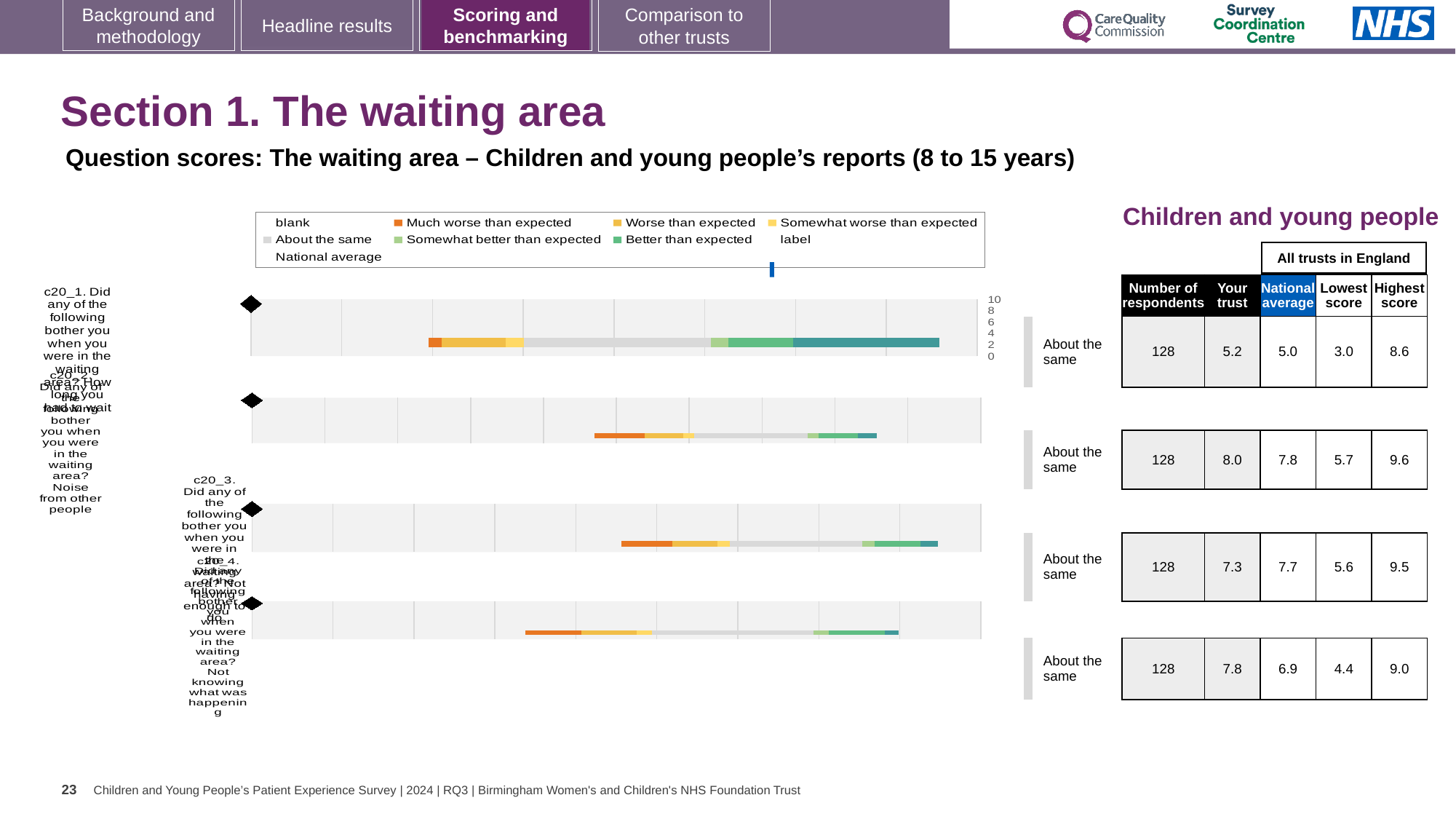
In the table next to the top chart (c20_1), what is the 'Your trust' score? 5.2 How many respondents are listed in the table for each of the four questions? 128 In the table next to the top chart (c20_1), what is the national average? 5.0 How many question bar charts are shown on the slide? 4 What colour does the legend use for 'Much worse than expected'? Orange Which of the four charts has the highest 'Your trust' score in the table? c20_2 (second chart), 8.0 Which of the four charts has the lowest 'Your trust' score in the table? c20_1 (top chart), 5.2 What kind of chart is used to show the question scores on this slide? bar chart In the table next to the bottom chart (c20_4), what is the difference between the 'Your trust' score and the national average? 0.9 In the table next to the second chart (c20_2), what is the highest score across all trusts in England? 9.6 In the table next to the third chart (c20_3), which is larger: the 'Your trust' score or the national average? National average In the table next to the second chart (c20_2, how long you had to wait), what is the 'Your trust' score? 8.0